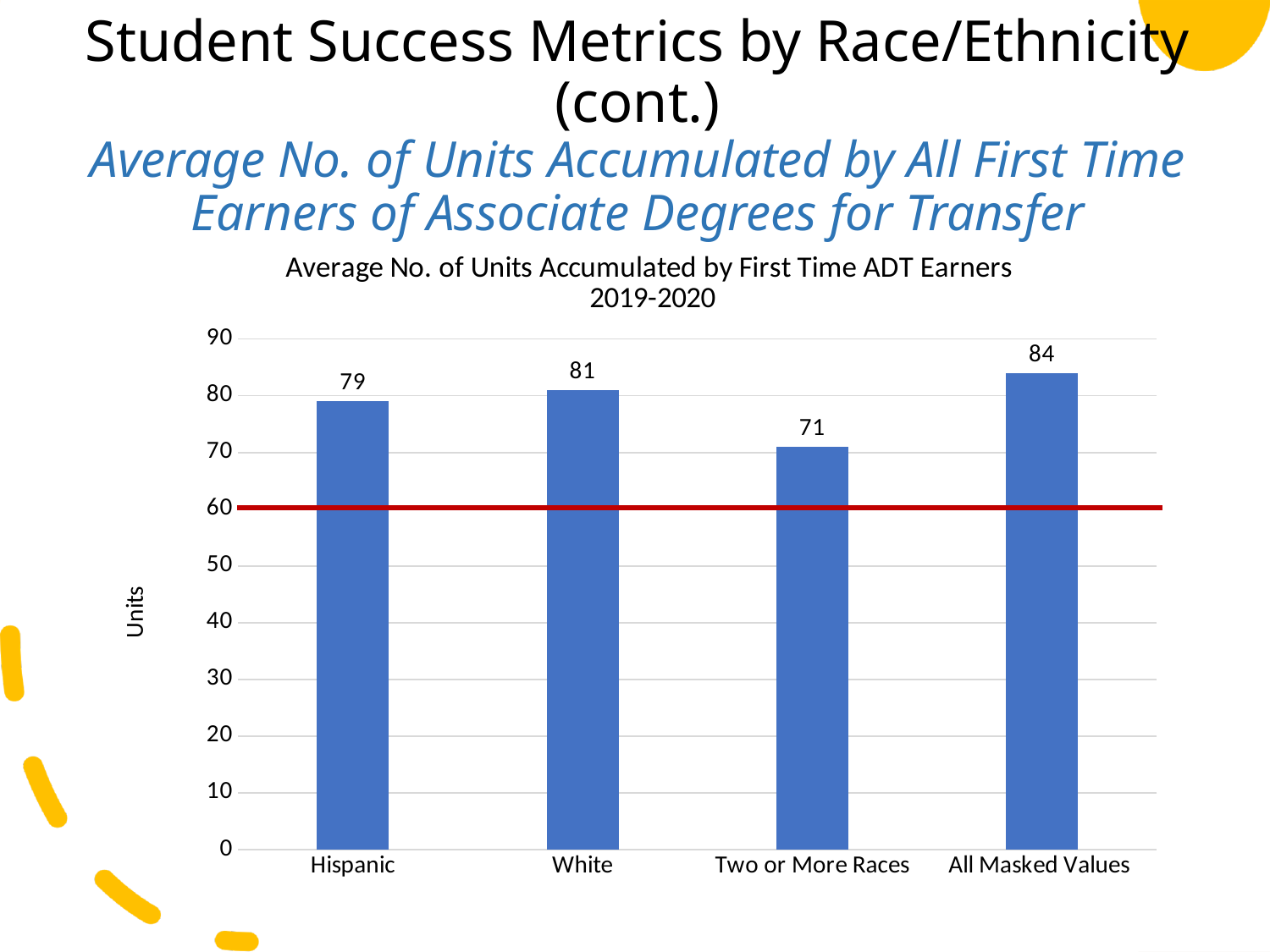
What is the value for Two or More Races? 71 Which category has the lowest average number of units? Two or More Races What kind of chart is shown on the slide? Bar chart What is the difference between the values for All Masked Values and Two or More Races? 13 How many categories are shown on the x axis? 4 What is the average number of units accumulated for Hispanic first time ADT earners? 79 What is the label on the vertical axis of the chart? Units Is the value for Two or More Races greater or less than 60? greater What is the value for White? 81 What is the value for All Masked Values? 84 Which is larger, the value for White or the value for Hispanic? White Which category has the highest average number of units? All Masked Values